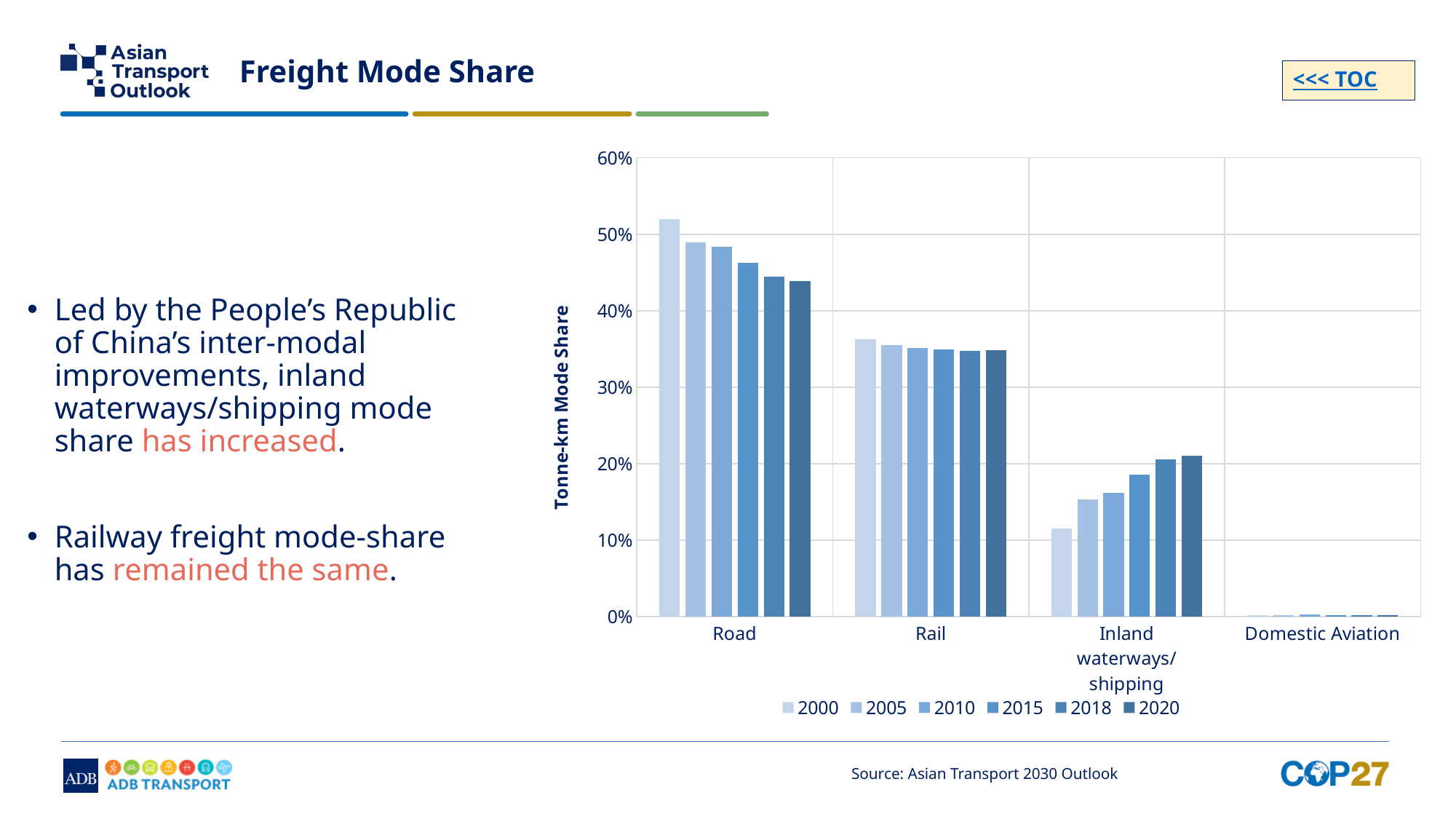
Which freight mode has the highest tonne-km mode share in 2000? Road Is the value for Rail in 2020 greater or less than 40%? less What kind of chart is shown on the slide? bar chart How many freight mode categories are shown on the x axis of the chart? 4 Does the mode share for Inland waterways/shipping rise or fall from 2000 to 2020? rise Does the mode share for Road rise or fall from 2000 to 2020? fall How many series (years) does the chart legend list? 6 Which freight mode has the lowest tonne-km mode share in 2020? Domestic Aviation What is the label of the vertical axis of the chart? Tonne-km Mode Share Is the value for Road in 2000 greater or less than 50%? greater Is the value for Road in 2020 greater or less than 50%? less